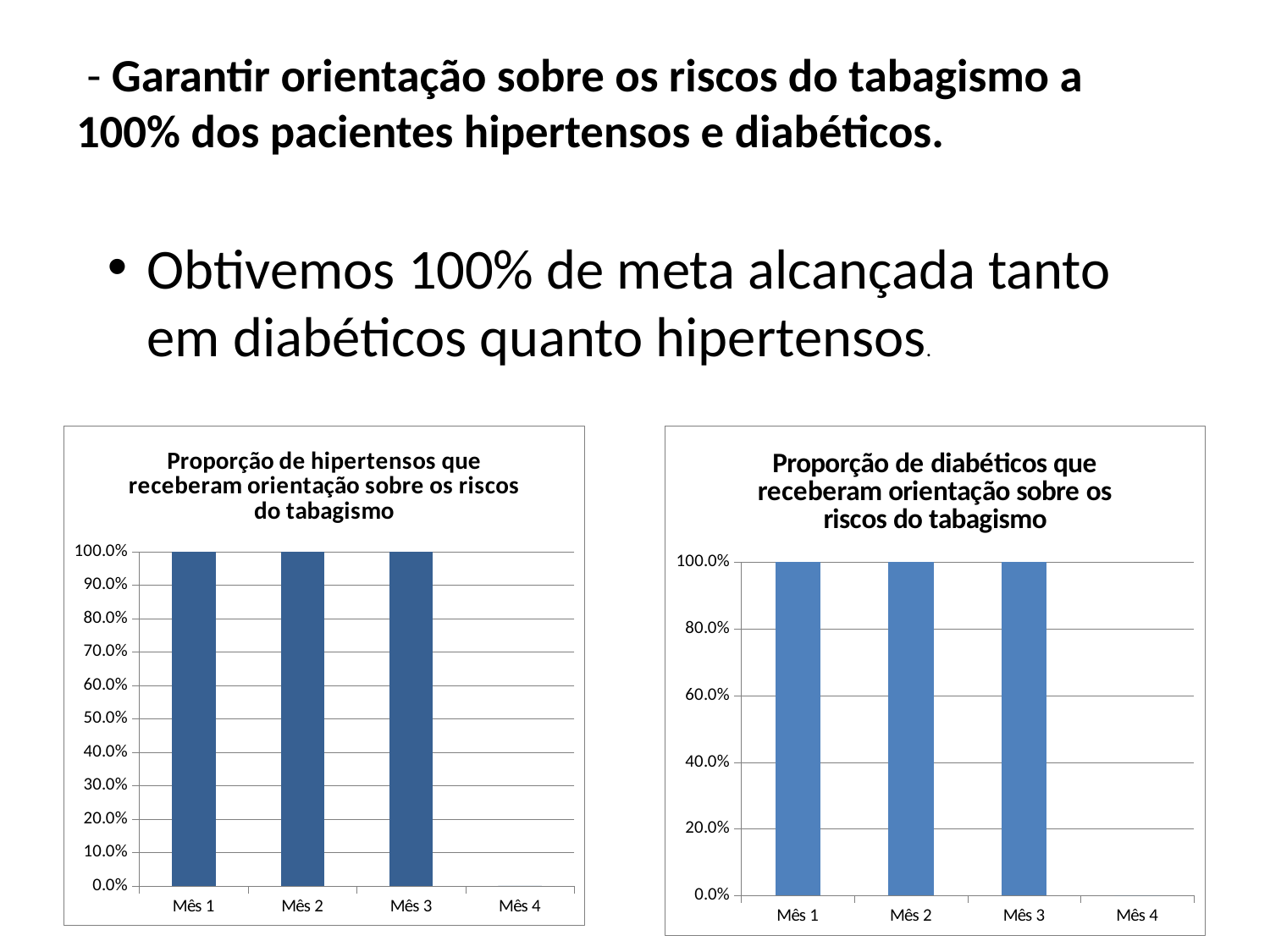
In the left chart (Proporção de hipertensos), is the value for Mês 3 greater or less than 50.0%? greater In the left chart (Proporção de hipertensos), what is the value for Mês 2? 100.0% How many categories are shown on the x axis of the left chart (Proporção de hipertensos)? 4 What is the title of the right chart? Proporção de diabéticos que receberam orientação sobre os riscos do tabagismo How many categories are shown on the x axis of the right chart (Proporção de diabéticos)? 4 In the right chart (Proporção de diabéticos), is the value for Mês 1 greater or less than 80.0%? greater In the left chart (Proporção de hipertensos), what is the difference between the values for Mês 1 and Mês 3? 0.0% What kind of chart is the left chart (Proporção de hipertensos)? bar chart In the right chart (Proporção de diabéticos), what is the value for Mês 3? 100.0% In the left chart (Proporção de hipertensos), what is the value for Mês 1? 100.0% In the right chart (Proporção de diabéticos), what is the value for Mês 2? 100.0% What kind of chart is the right chart (Proporção de diabéticos)? bar chart